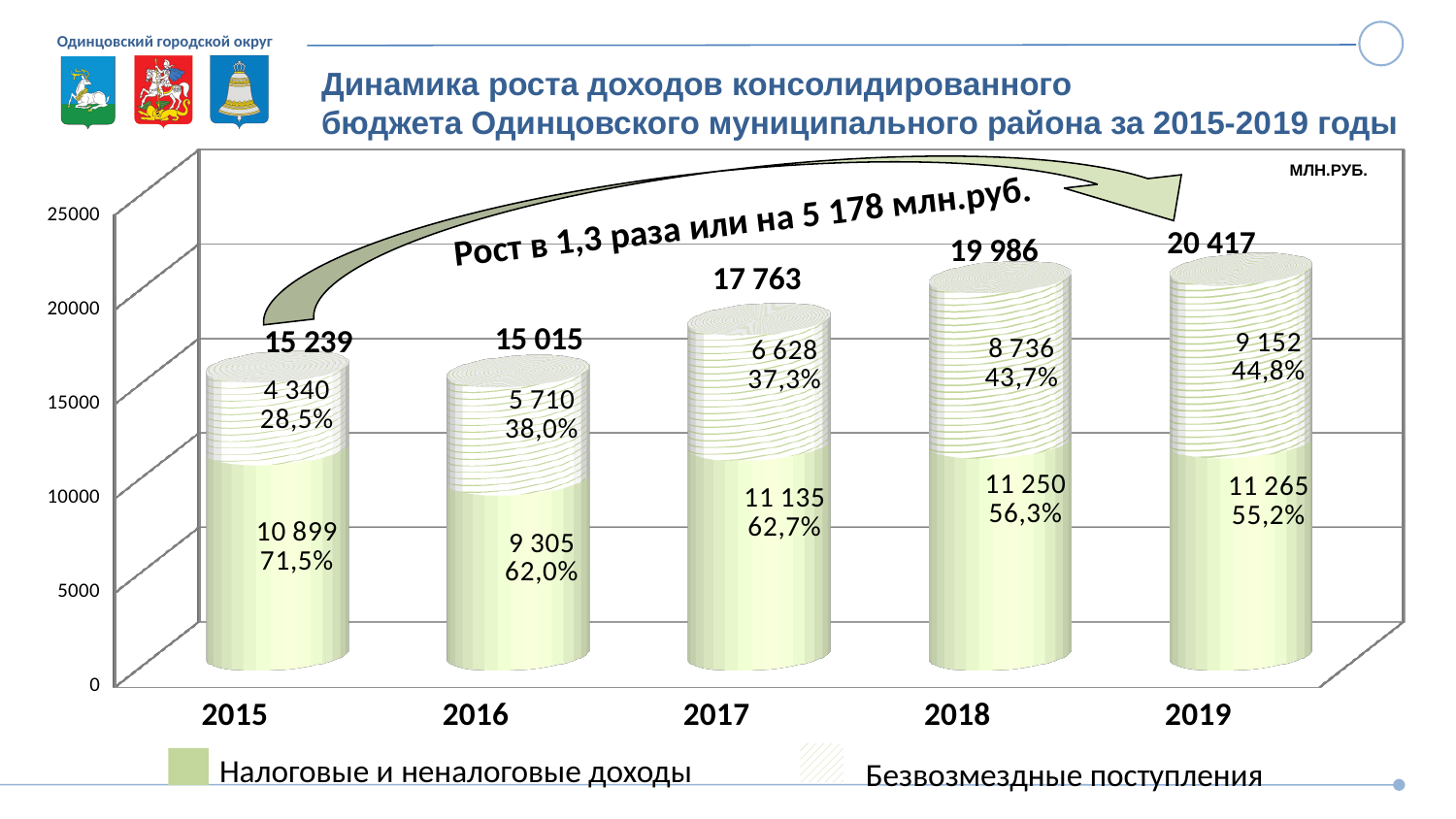
Which is larger: Налоговые и неналоговые доходы in 2015 or in 2016? 2015 How many years are shown on the x axis? 5 Which year has the lowest total consolidated budget income? 2016 Which year has the highest total consolidated budget income? 2019 What is the value of Налоговые и неналоговые доходы for 2017? 11 135 How many series does the legend list? 2 What kind of chart is shown on the slide? Stacked bar chart What share of the 2016 total do Налоговые и неналоговые доходы make up, as printed on the slide? 62,0% What is the value of Безвозмездные поступления for 2019? 9 152 What unit of measurement is indicated in the top right corner of the chart? МЛН.РУБ. What is the difference between the Безвозмездные поступления values for 2018 and 2017? 2 108 What is the total of the stacked bar for 2018? 19 986